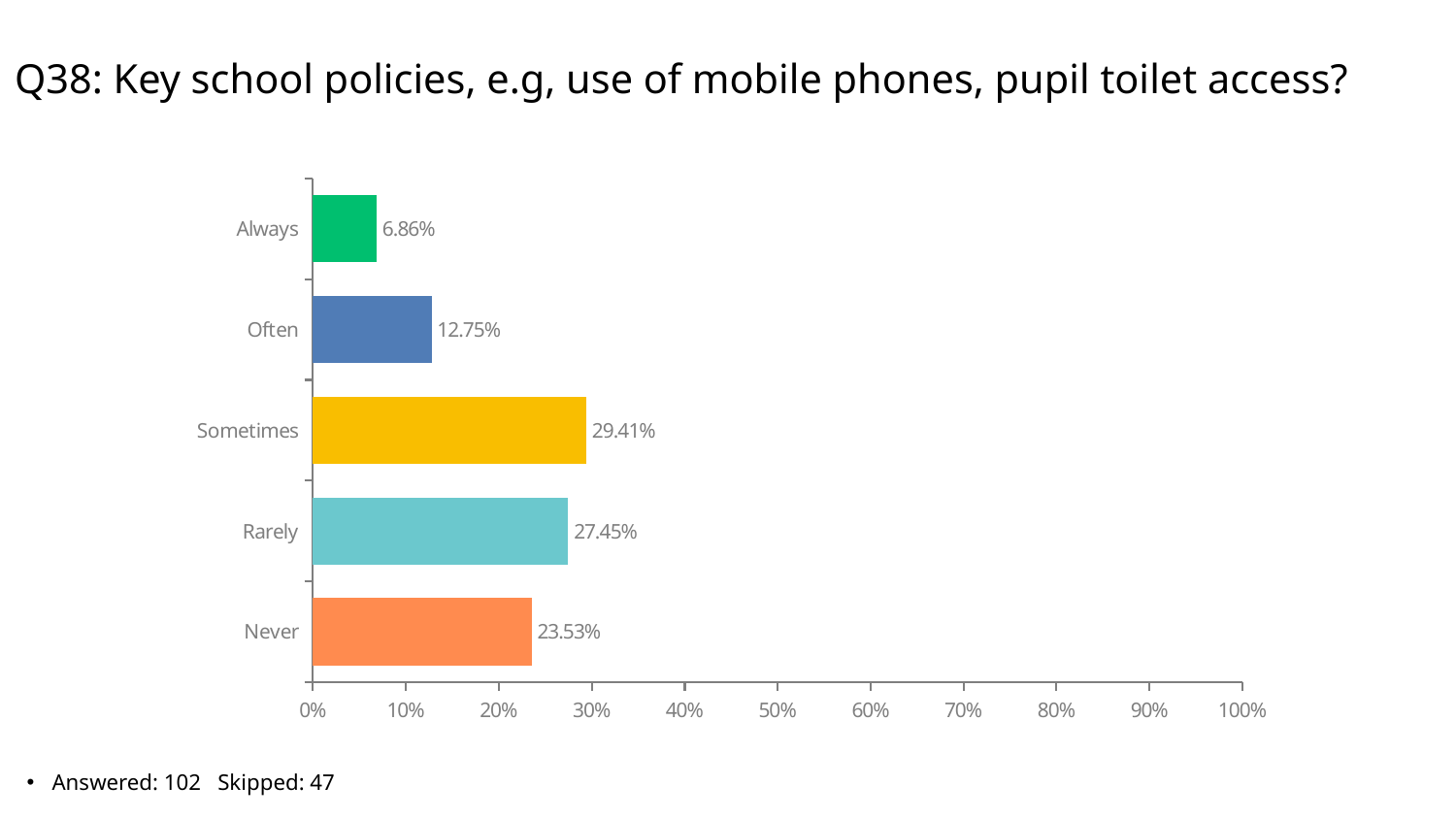
What percentage is shown for 'Never'? 23.53% Which category has the lowest value? Always What kind of chart is shown on the slide? Bar chart Which is larger, the value for 'Rarely' or the value for 'Never'? Rarely What is the value for 'Always'? 6.86% Which category has the highest value? Sometimes What is the difference between the values for 'Sometimes' and 'Rarely'? 1.96% What is the title of the chart? Q38: Key school policies, e.g, use of mobile phones, pupil toilet access? Is the value for 'Often' greater or less than 20%? less How many categories are shown in the chart? 5 What is the difference between the values for 'Often' and 'Always'? 5.89% What percentage is shown for the 'Sometimes' category? 29.41%